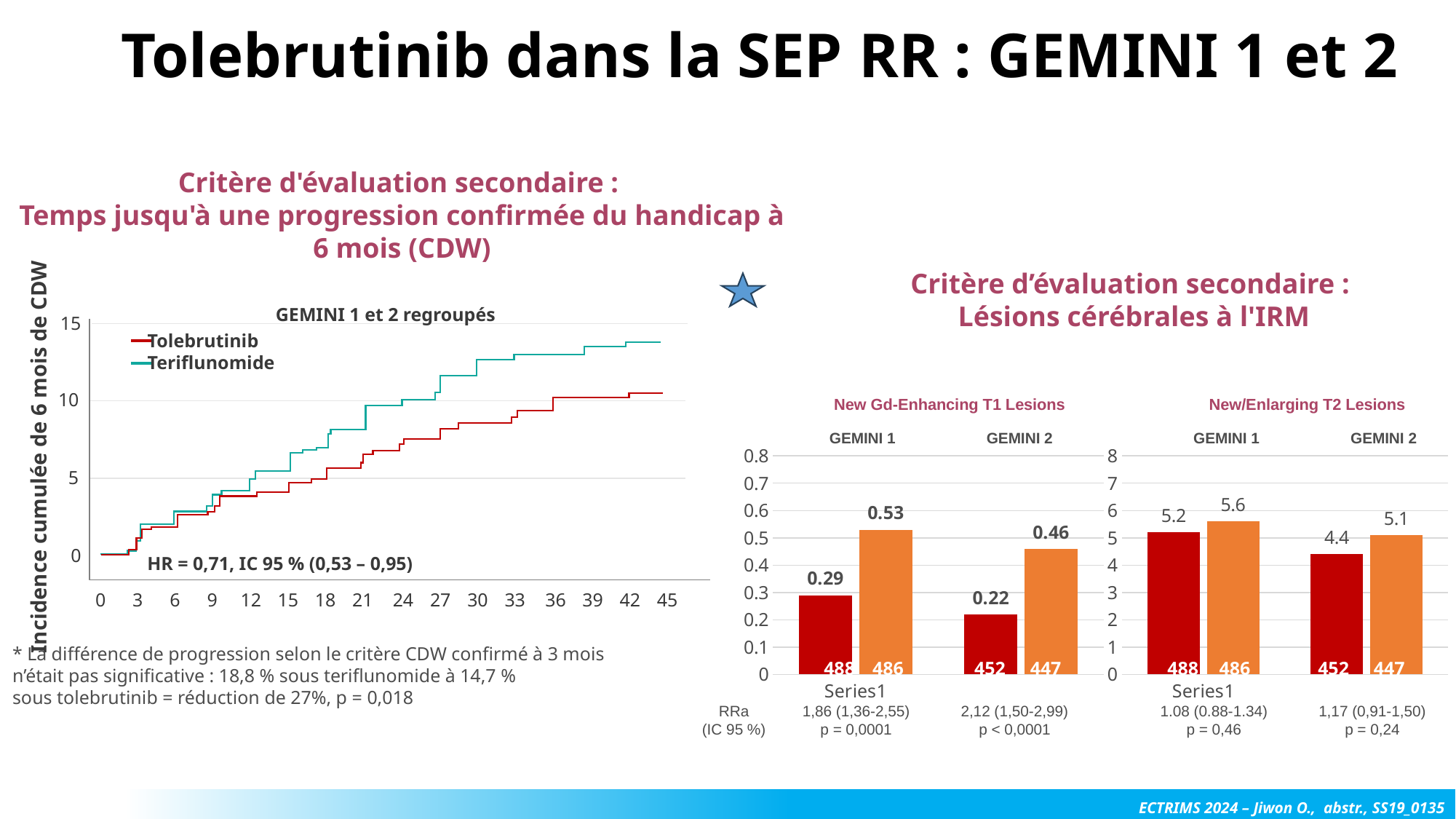
What kind of chart is the 'New Gd-Enhancing T1 Lesions' chart? bar chart In the 'New/Enlarging T2 Lesions' chart, what is the value of the red bar for GEMINI 2? 4.4 How many series does the legend of the 'GEMINI 1 et 2 regroupés' chart list? 2 In the 'New Gd-Enhancing T1 Lesions' chart, what is the value of the orange bar for GEMINI 2? 0.46 In the 'New Gd-Enhancing T1 Lesions' chart, what is the value of the red bar for GEMINI 1? 0.29 In the 'GEMINI 1 et 2 regroupés' chart, is the Teriflunomide value at month 45 greater or less than 10? greater In the 'New/Enlarging T2 Lesions' chart, which bar is the lowest? GEMINI 2 red bar (4.4) In the 'GEMINI 1 et 2 regroupés' chart, which series reaches the higher cumulative incidence at month 45, Tolebrutinib or Teriflunomide? Teriflunomide What kind of chart is the 'GEMINI 1 et 2 regroupés' chart on the left? line chart In the 'GEMINI 1 et 2 regroupés' chart, do the curves rise or fall as the months increase? rise In the 'New Gd-Enhancing T1 Lesions' chart, what is the difference between the orange and red bars for GEMINI 1? 0.24 In the 'New Gd-Enhancing T1 Lesions' chart, which bar is the highest? GEMINI 1 orange bar (0.53)